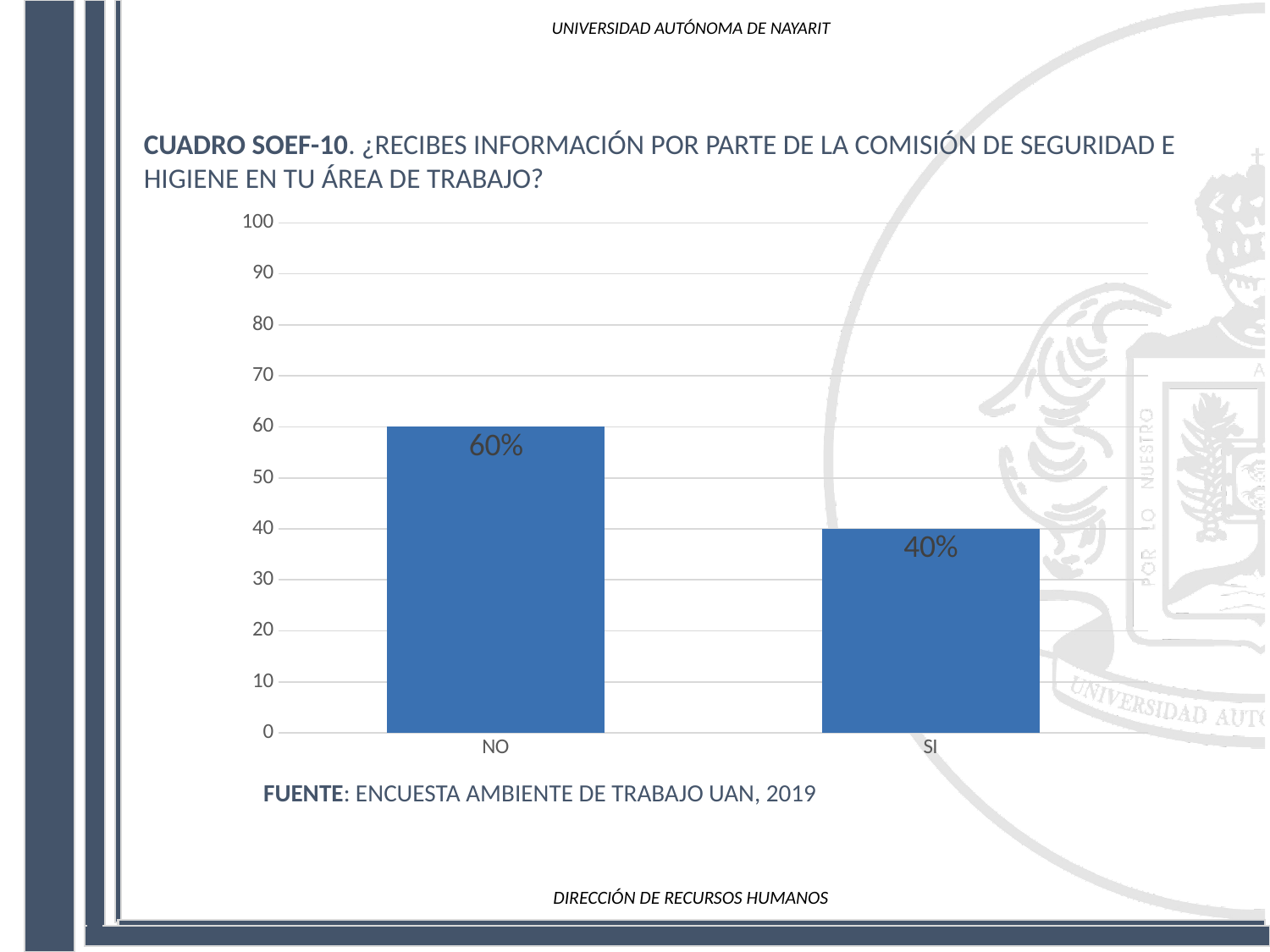
Which category has the lowest value? SI What is the highest value shown on the y axis? 100 Is the value for NO greater or less than 50? greater Which is larger, the value for NO or the value for SI? NO What is the value for NO? 60% Is the value for SI greater or less than 50? less What source is cited below the chart? ENCUESTA AMBIENTE DE TRABAJO UAN, 2019 Which category has the highest value? NO What is the difference between the values for NO and SI? 20% How many categories are shown on the x axis? 2 What kind of chart is shown on the slide? bar chart What is the value for SI? 40%